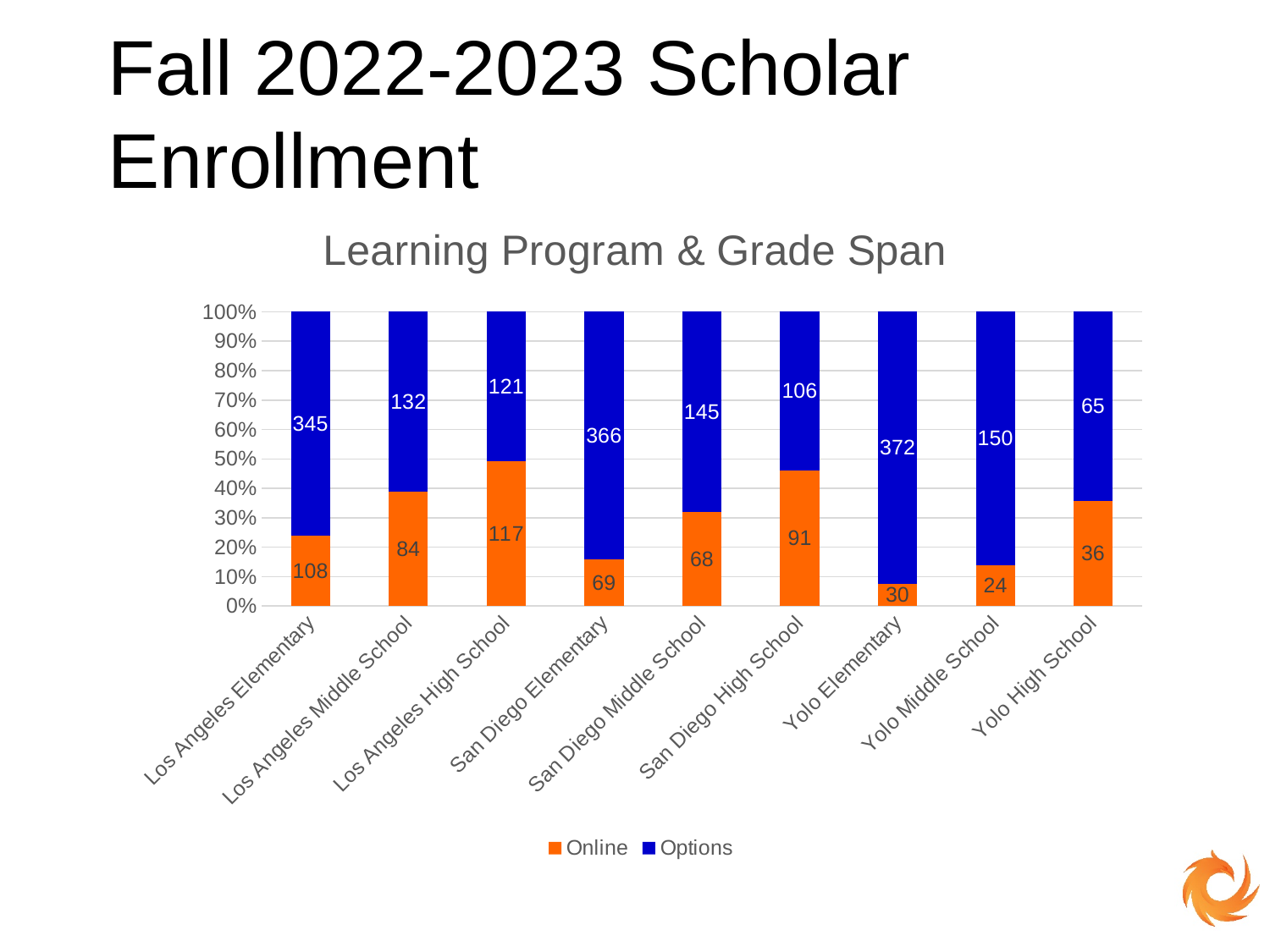
What is the Options enrollment value for San Diego Elementary? 366 What kind of chart is shown on the slide? Stacked bar chart What is the difference between the Options and Online values for Los Angeles Middle School? 48 How many categories are shown on the x axis? 9 Which category has the lowest Online enrollment value? Yolo Middle School What is the Online enrollment value for Los Angeles Elementary? 108 How many series does the legend list? 2 Is the Online share of the Los Angeles Elementary bar greater or less than 30%? less What is the Online enrollment value for Yolo High School? 36 Which is larger, the Online value for San Diego High School or the Online value for San Diego Middle School? San Diego High School What is the total enrollment (Online plus Options) for Yolo High School? 101 Which category has the highest Options enrollment value? Yolo Elementary